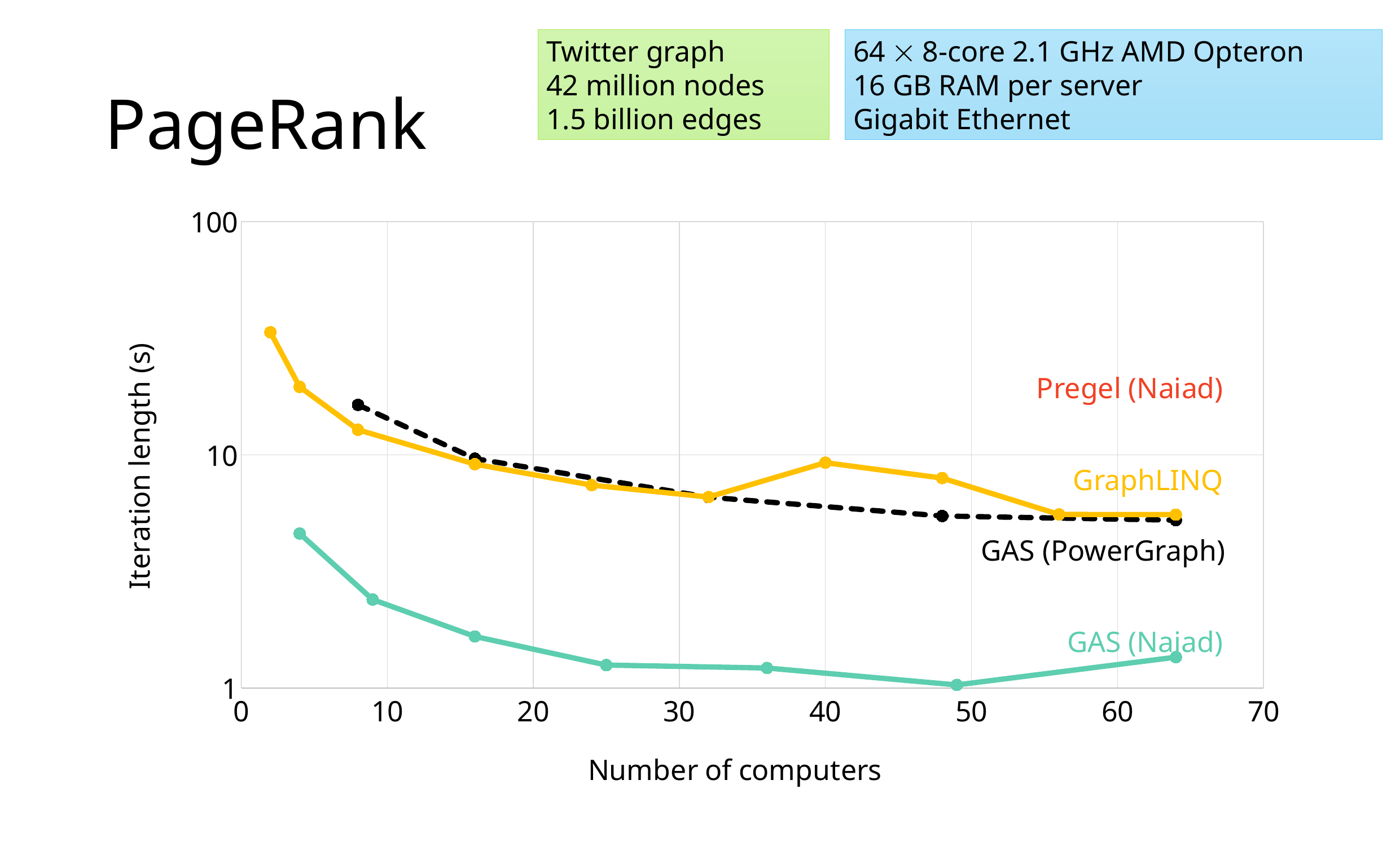
Is the iteration length for GraphLINQ at 2 computers greater or less than 10? greater Is the iteration length for GAS (PowerGraph) at 8 computers greater or less than 10? greater How many data points are plotted for the GAS (PowerGraph) series? 5 What kind of chart is shown on the slide? line chart What is the label of the y axis? Iteration length (s) Is the iteration length for GraphLINQ at 64 computers greater or less than 10? less How many data points are plotted for the GAS (Naiad) series? 7 Which series has the lowest iteration length across the chart? GAS (Naiad) What is the label of the x axis? Number of computers Does the iteration length for GAS (PowerGraph) rise or fall as the number of computers increases? fall At 16 computers, which has the larger iteration length, GraphLINQ or GAS (Naiad)? GraphLINQ